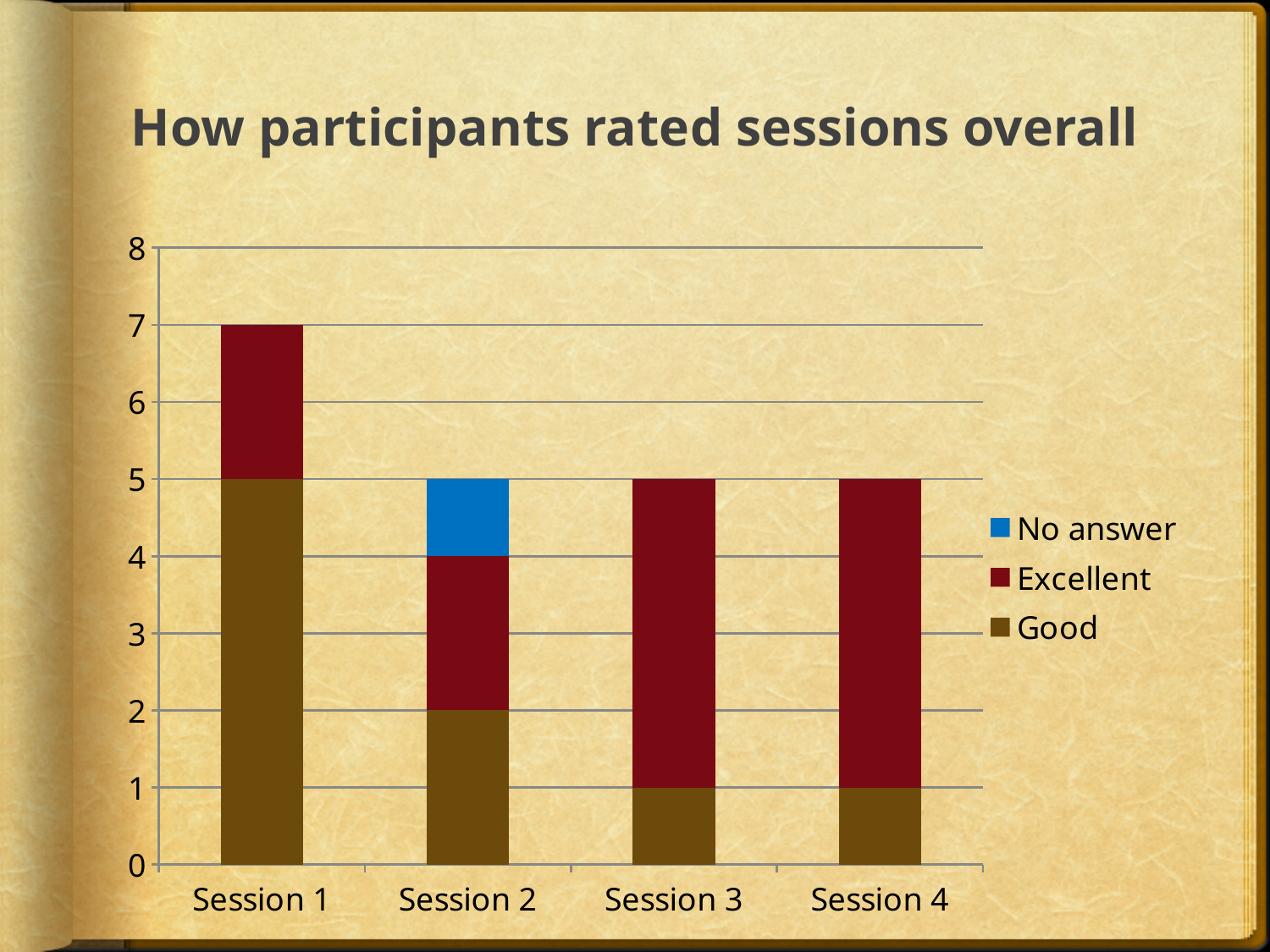
Which session is the only one with a No answer segment? Session 2 Which session has the highest total bar? Session 1 What is the total height of the stacked bar for Session 2? 5 What is the Good value for Session 1? 5 What kind of chart is shown on the slide? Stacked bar chart What is the Good value for Session 3? 1 What is the total height of the stacked bar for Session 1? 7 Is the Good value for Session 2 larger or smaller than the Good value for Session 4? Larger How many sessions are shown on the x axis? 4 Which session has the highest Good value? Session 1 How many series does the legend list? 3 What is the title of the chart? How participants rated sessions overall